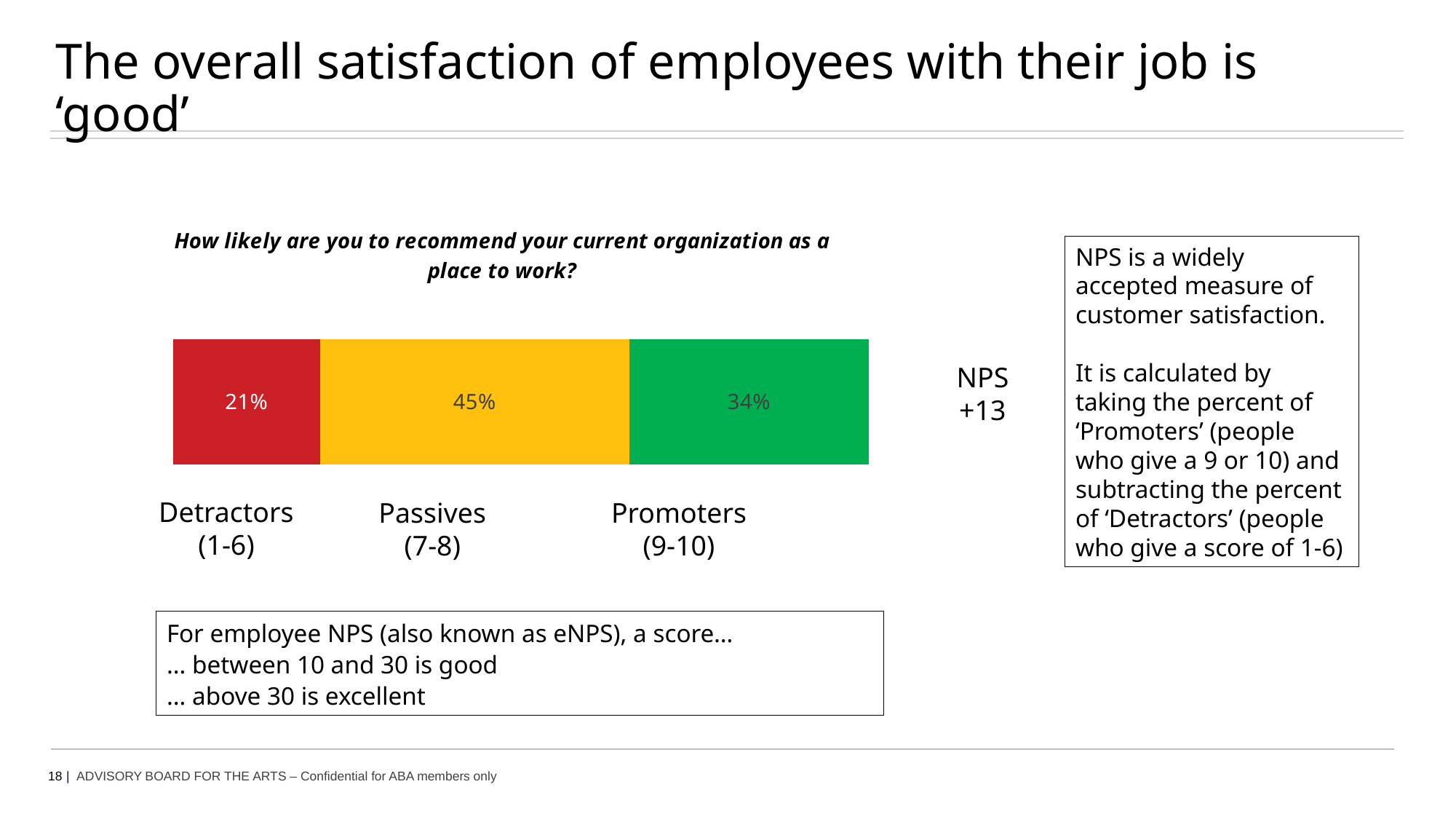
What percentage of respondents are Passives (7-8)? 45% What percentage of respondents are Detractors (1-6)? 21% What type of chart is shown on the slide? Stacked bar chart What colour is the Promoters (9-10) segment of the bar? Green What percentage of respondents are Promoters (9-10)? 34% How many segments make up the stacked bar? 3 Which is larger, the share of Promoters or the share of Detractors? Promoters Which group has the smallest share of respondents? Detractors (1-6) What is the difference in percentage points between Passives and Promoters? 11 What is the total of the three segments in the stacked bar? 100% What is the difference in percentage points between Promoters and Detractors? 13 Which group has the largest share of respondents? Passives (7-8)